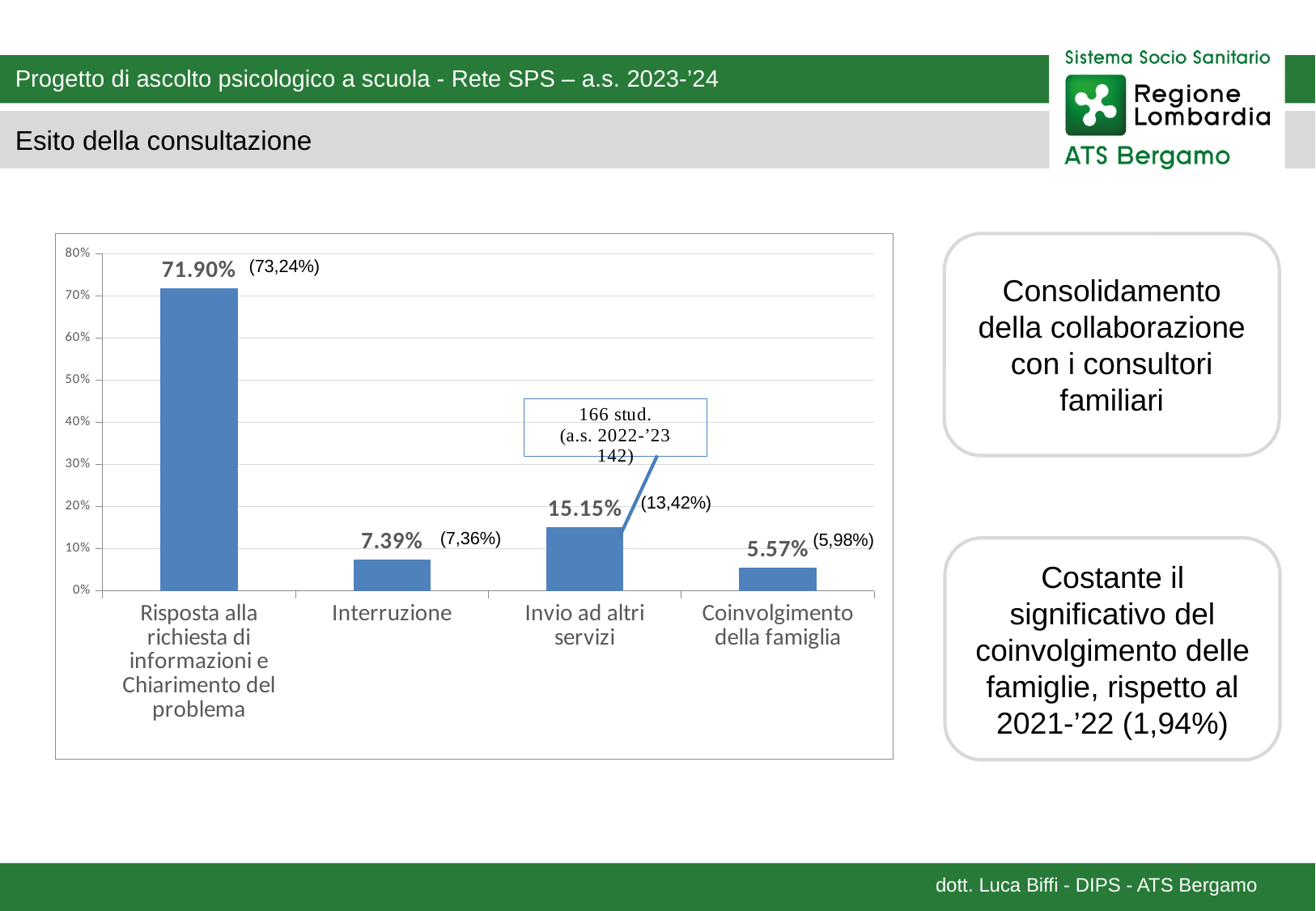
What number of students is given in the annotation box pointing to the "Invio ad altri servizi" bar? 166 stud. What is the value for "Risposta alla richiesta di informazioni e Chiarimento del problema"? 71.90% Is the value for "Risposta alla richiesta di informazioni e Chiarimento del problema" greater or less than 70%? greater What is the value for "Invio ad altri servizi"? 15.15% Which category has the highest value? Risposta alla richiesta di informazioni e Chiarimento del problema What kind of chart is shown on the slide? bar chart Which is larger, the value for "Interruzione" or the value for "Invio ad altri servizi"? Invio ad altri servizi Which category has the lowest value? Coinvolgimento della famiglia What is the difference between the values for "Invio ad altri servizi" and "Interruzione"? 7.76% How many categories are plotted in the chart? 4 What is the value for "Coinvolgimento della famiglia"? 5.57% What is the value for "Interruzione"? 7.39%